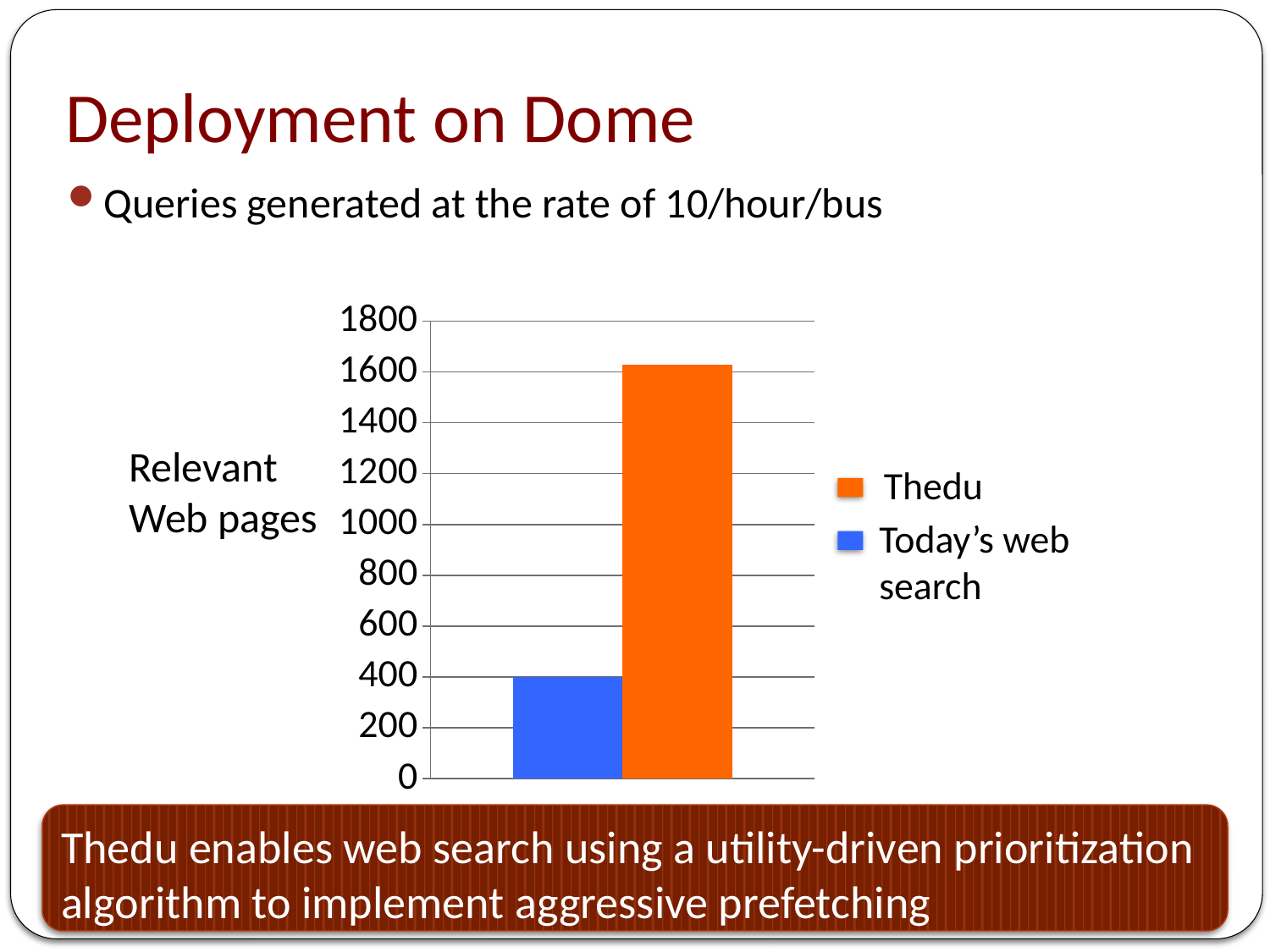
What colour is the bar for Thedu? orange What is the label on the vertical axis of the chart? Relevant Web pages Is the value for Today's web search greater or less than 200? greater Is the value for Thedu greater or less than 1600? greater What kind of chart is shown on the slide? bar chart Which series has the lowest value in the chart? Today's web search Which series has the higher value, Thedu or Today's web search? Thedu How many series does the chart's legend list? 2 Is the value for Thedu greater or less than 1800? less Which series has the highest value in the chart? Thedu